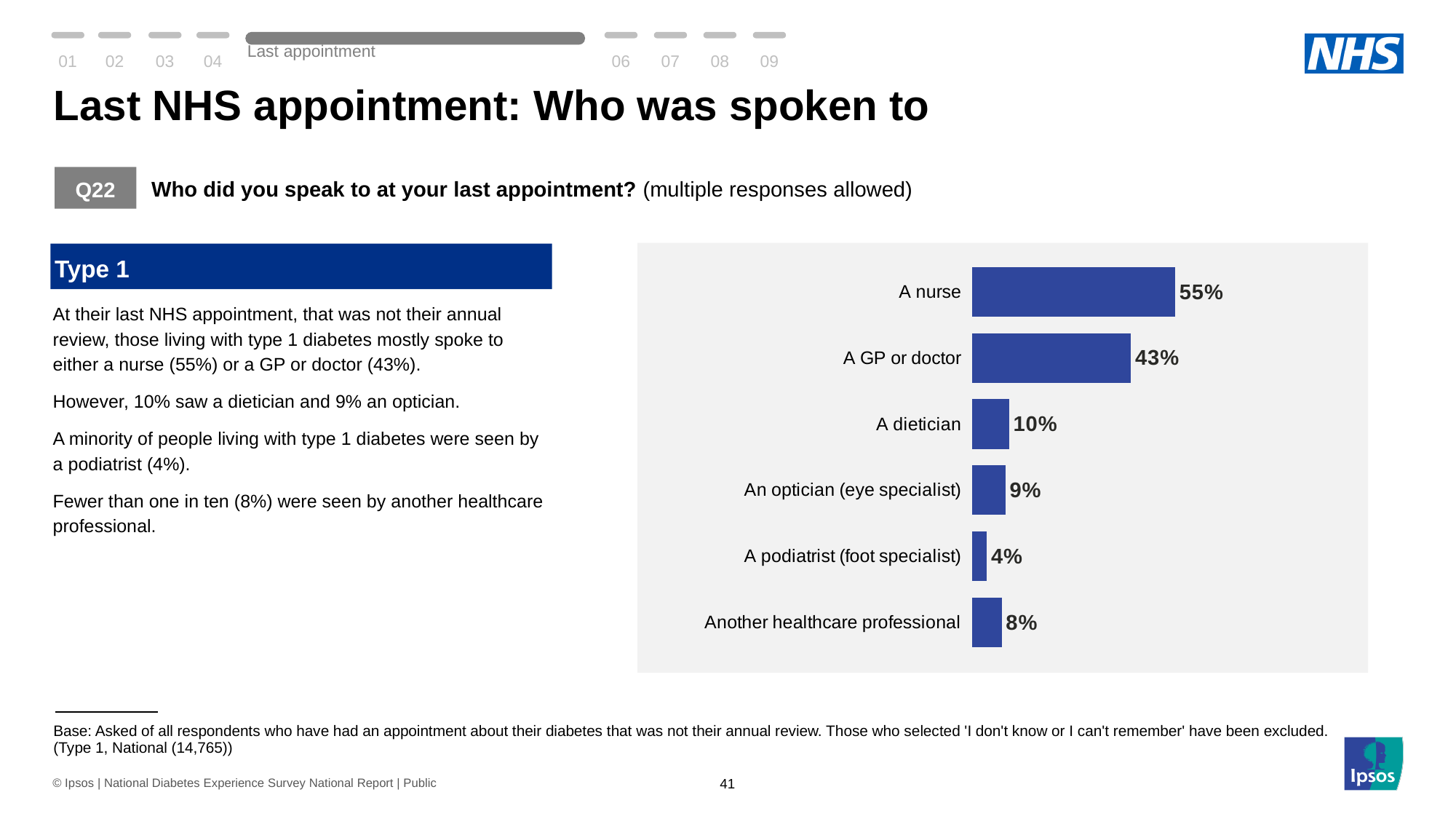
Which category has the lowest value in the chart? A podiatrist (foot specialist) What percentage of respondents spoke to a nurse at their last appointment? 55% What is the value shown for 'A GP or doctor'? 43% Which diabetes type does the chart on this slide cover? Type 1 What is the difference between the values for 'A nurse' and 'A GP or doctor'? 12 percentage points How many categories are shown in the chart? 6 What percentage spoke to a podiatrist (foot specialist)? 4% Which category has the highest value in the chart? A nurse What is the difference between the values for 'A dietician' and 'A podiatrist (foot specialist)'? 6 percentage points What is the value for 'Another healthcare professional'? 8% Which is larger: the value for 'A dietician' or the value for 'An optician (eye specialist)'? A dietician What kind of chart is shown on the slide? Bar chart